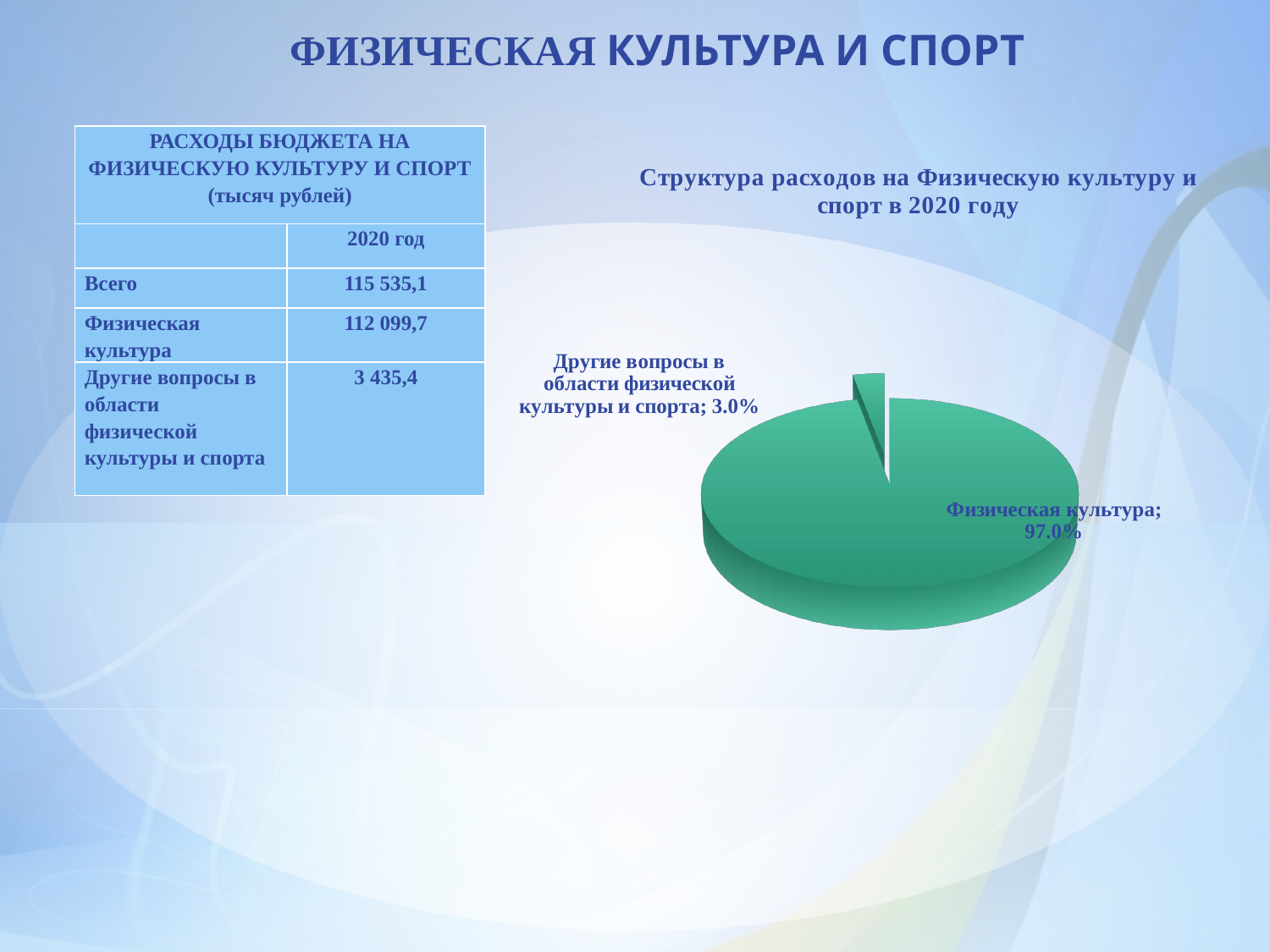
What kind of chart is shown on the slide? Pie chart Which is larger in the pie chart: "Физическая культура" or "Другие вопросы в области физической культуры и спорта"? Физическая культура What is the title of the pie chart? Структура расходов на Физическую культуру и спорт в 2020 году How many slices does the pie chart have? 2 Is the share for "Другие вопросы в области физической культуры и спорта" greater or less than 10%? less Which slice of the pie chart is the largest? Физическая культура What year does the pie chart's title say the expenditure structure refers to? 2020 What share of the pie does "Другие вопросы в области физической культуры и спорта" have? 3.0% What is the difference in percentage points between the "Физическая культура" slice and the "Другие вопросы в области физической культуры и спорта" slice? 94.0% What share of the pie does "Физическая культура" have? 97.0% Which slice of the pie chart is the smallest? Другие вопросы в области физической культуры и спорта Is the share for "Физическая культура" greater or less than 90%? greater